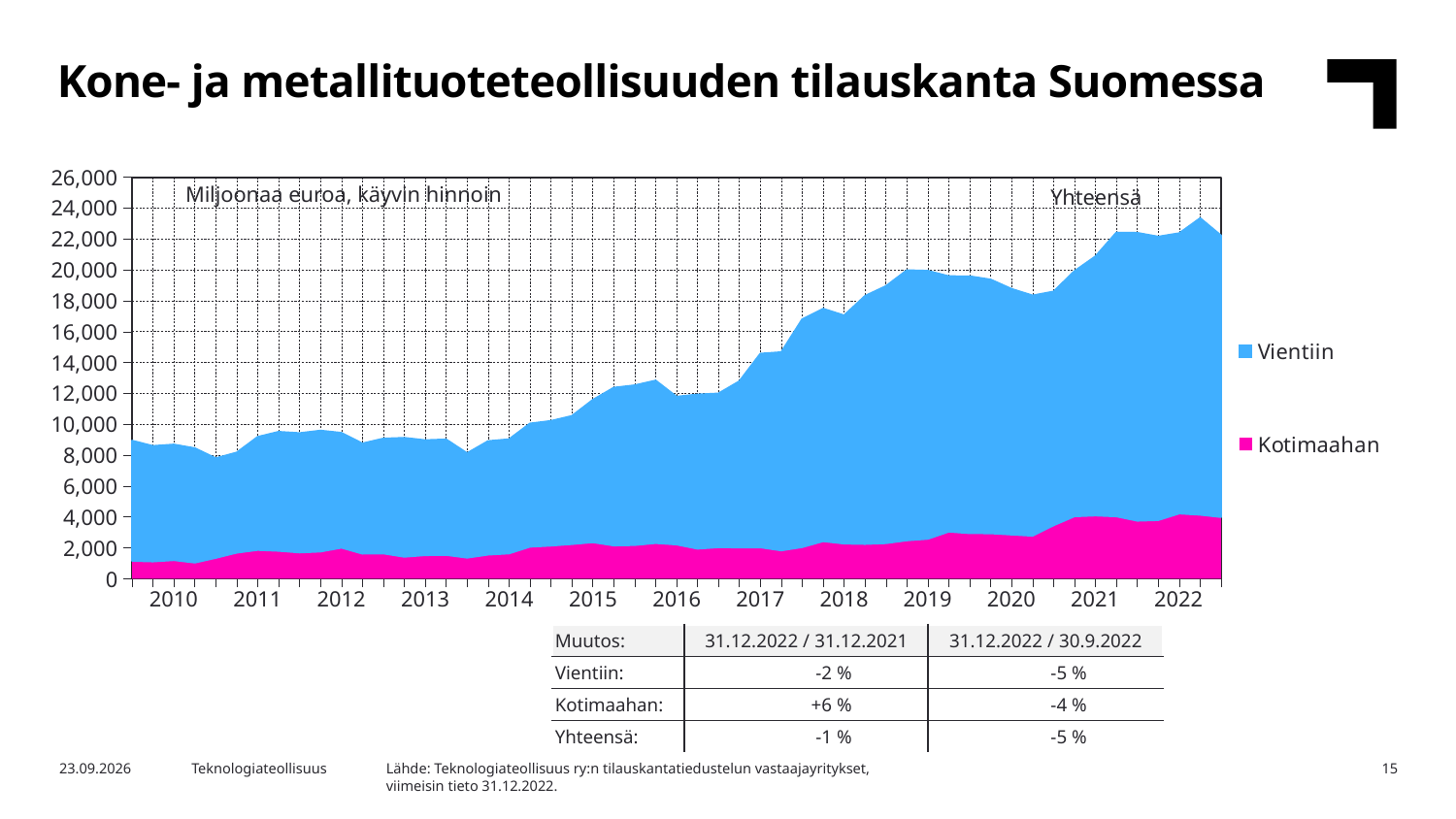
Is the value for Kotimaahan at the start of 2010 greater or less than 2,000? less How many series does the chart legend list? 2 Which is larger: the total order book in 2022 or in 2010? 2022 Which two series are listed in the chart legend? Vientiin and Kotimaahan Does the total order book (Yhteensä) generally rise or fall from 2010 to 2022? rise Is the total order book (Yhteensä) at the start of 2022 greater or less than 20,000? greater Is the total order book (Yhteensä) at the start of 2010 greater or less than 10,000? less What unit label is printed inside the chart area? Miljoonaa euroa, käyvin hinnoin What kind of chart is shown on the slide? Stacked area chart How many years are labeled on the x axis of the chart? 13